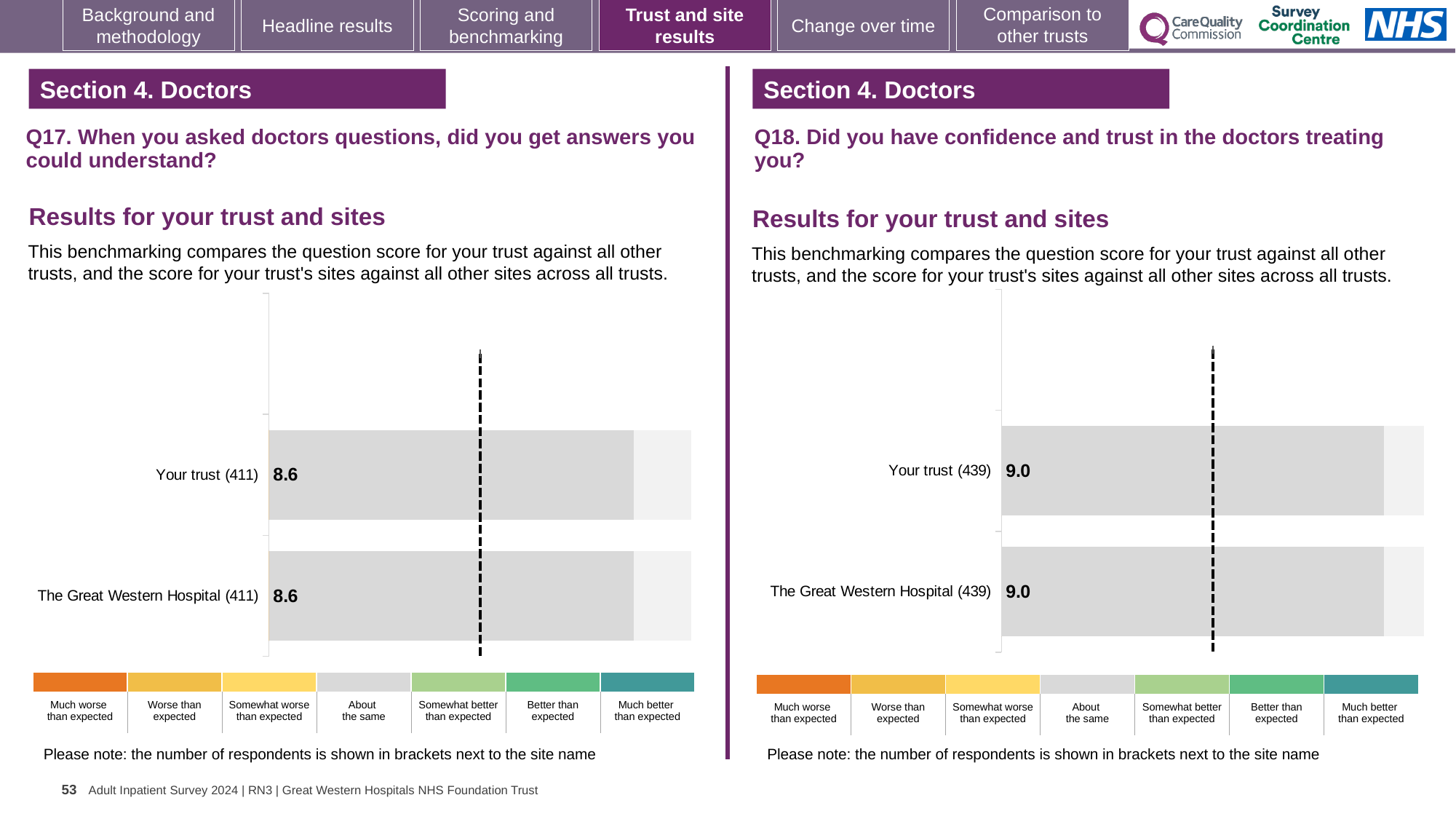
On the Q18 chart (right), what is the score for Your trust? 9.0 How many bars are plotted on the Q17 chart (left)? 2 On the Q17 chart (left), what is the score for The Great Western Hospital? 8.6 On the Q18 chart (right), what is the score for The Great Western Hospital? 9.0 On the Q17 chart (left), what is the score for Your trust? 8.6 Which is larger: the Your trust score on the Q18 chart (right) or the Your trust score on the Q17 chart (left)? Q18 (9.0) On the Q17 chart (left), how many respondents are shown in brackets next to Your trust? 411 What kind of chart is used for the Q18 results (right)? Bar chart How many bars are plotted on the Q18 chart (right)? 2 What is the difference between the Your trust score on the Q18 chart (right) and the Your trust score on the Q17 chart (left)? 0.4 On the Q18 chart (right), how many respondents are shown in brackets next to The Great Western Hospital? 439